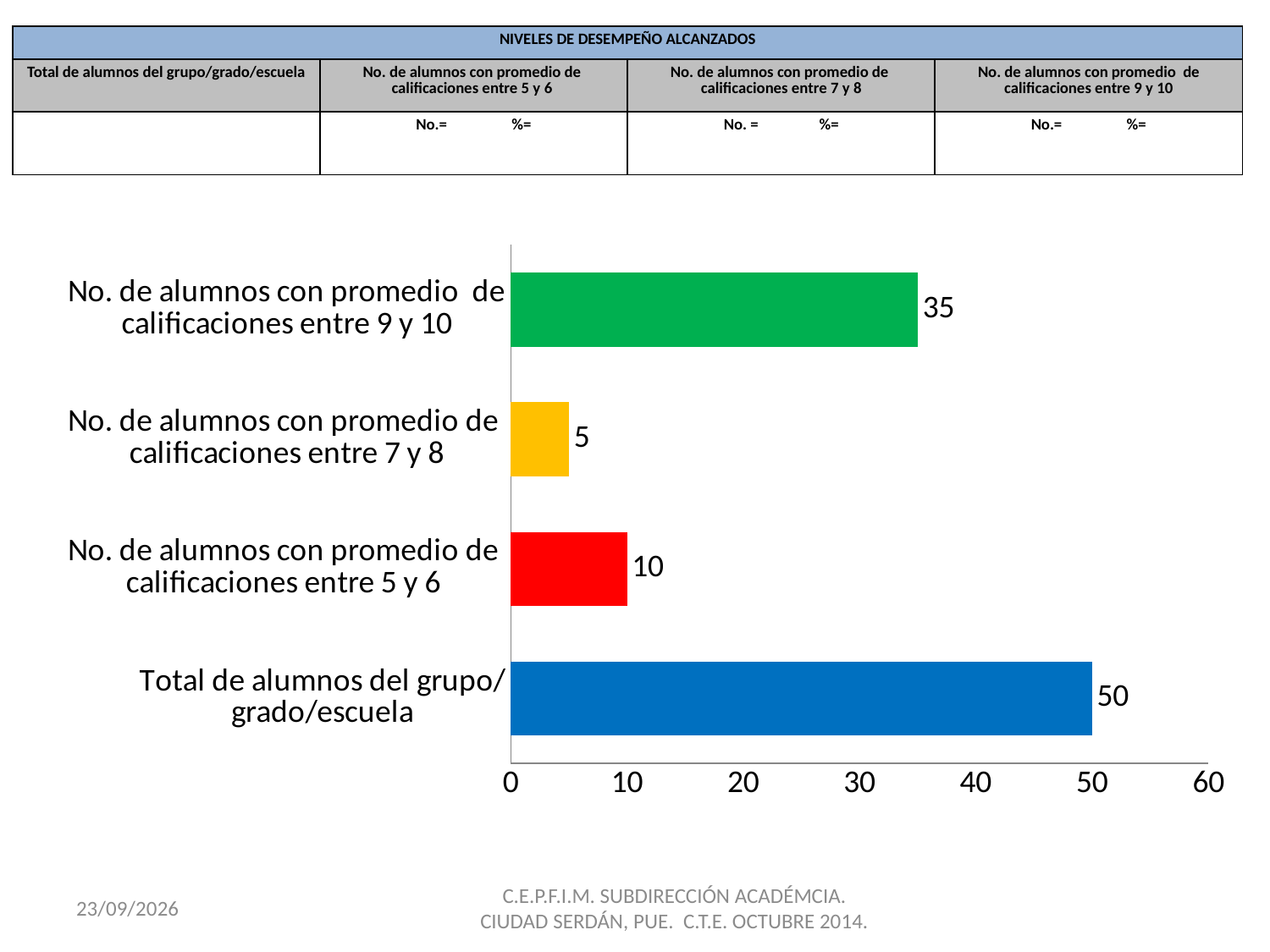
What kind of chart is shown on the slide? bar chart What is the value for 'Total de alumnos del grupo/grado/escuela'? 50 Which is larger: the value for students with averages between 5 and 6 or the value for students with averages between 7 and 8? No. de alumnos con promedio de calificaciones entre 5 y 6 What is the value for 'No. de alumnos con promedio de calificaciones entre 5 y 6'? 10 Is the value for 'No. de alumnos con promedio de calificaciones entre 9 y 10' greater or less than 30? greater Which category has the highest value? Total de alumnos del grupo/grado/escuela What is the value for 'No. de alumnos con promedio de calificaciones entre 9 y 10'? 35 How many categories are shown in the chart? 4 What is the value for 'No. de alumnos con promedio de calificaciones entre 7 y 8'? 5 Which category has the lowest value? No. de alumnos con promedio de calificaciones entre 7 y 8 What is the difference between the value for students with averages between 9 and 10 and the value for students with averages between 5 and 6? 25 What colour is the bar for 'Total de alumnos del grupo/grado/escuela'? blue